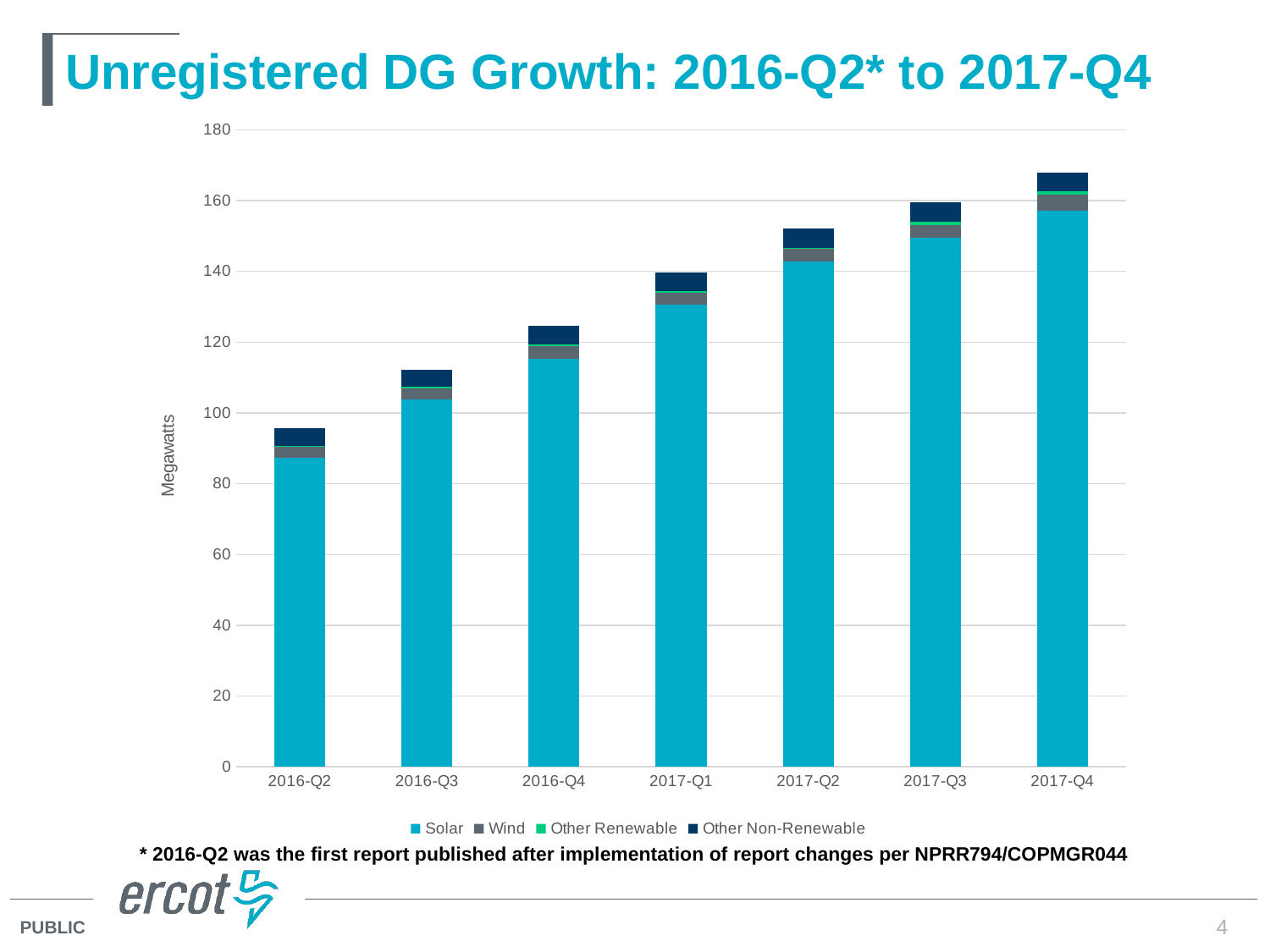
How many series does the chart's legend list? 4 Which series makes up the largest portion of each stacked bar? Solar Is the Solar value for 2017-Q2 greater or less than 140? greater Is the total bar height for 2017-Q4 greater or less than 160? greater How many quarters are shown along the x axis of the chart? 7 Is the total bar height for 2016-Q3 greater or less than 120? less Which quarter has the tallest stacked bar? 2017-Q4 Do the total bar heights rise or fall from 2016-Q2 to 2017-Q4? Rise Which quarter has the shortest stacked bar? 2016-Q2 What is the label on the chart's y axis? Megawatts What kind of chart is shown on the slide? Stacked bar chart